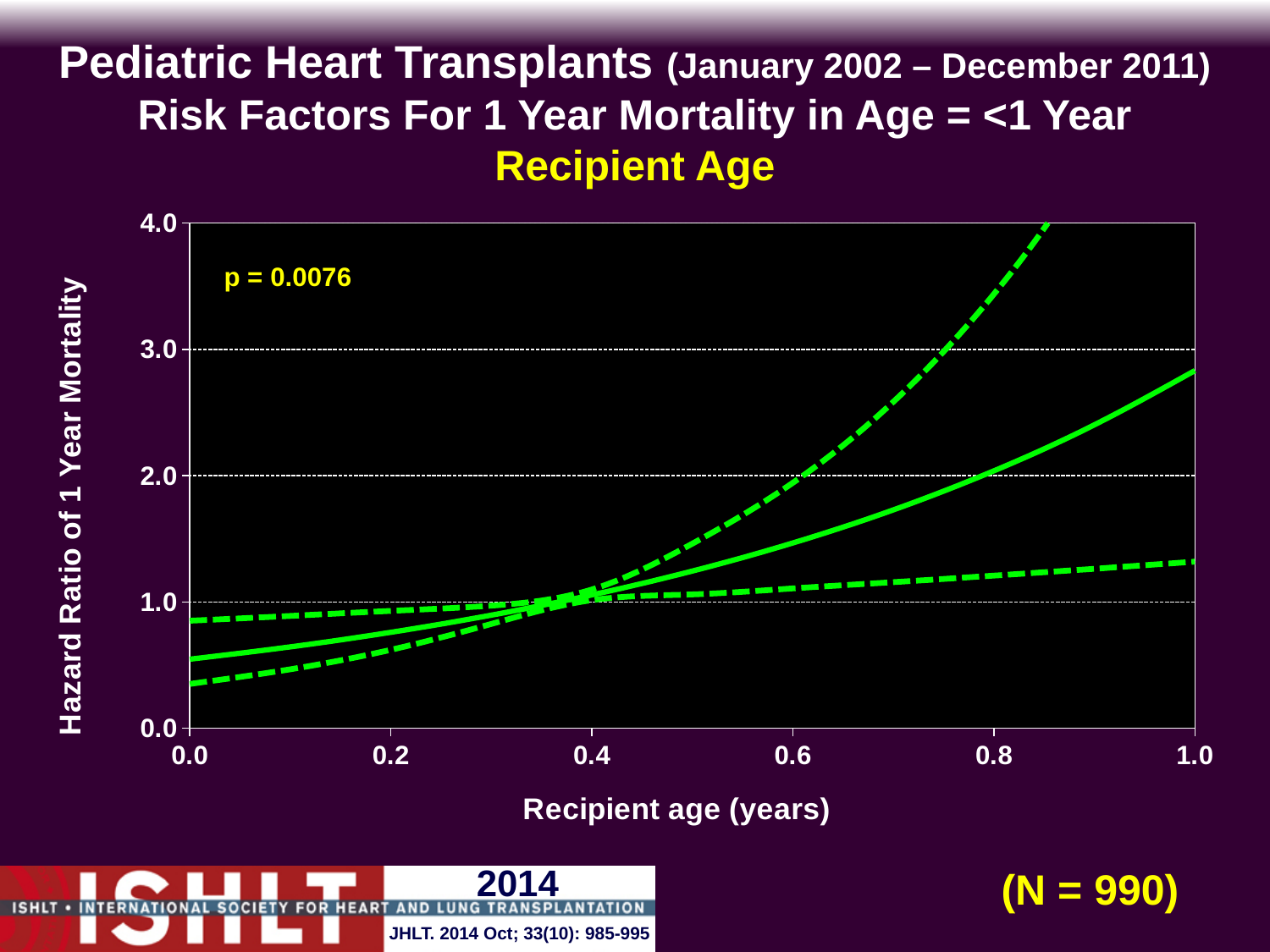
Is the value of the solid hazard ratio line at a recipient age of 1.0 years greater or less than 3.0? less Does the solid hazard ratio line rise or fall as recipient age increases from 0.0 to 1.0 years? Rises How many lines are plotted on the chart? 3 What kind of chart is shown on the slide? Line chart Is the value of the upper dashed line at a recipient age of 0.8 years greater or less than 3.0? greater What is the p-value shown on the chart? p = 0.0076 What is the label of the x axis? Recipient age (years) Is the value of the solid hazard ratio line at a recipient age of 0.0 years greater or less than 1.0? less